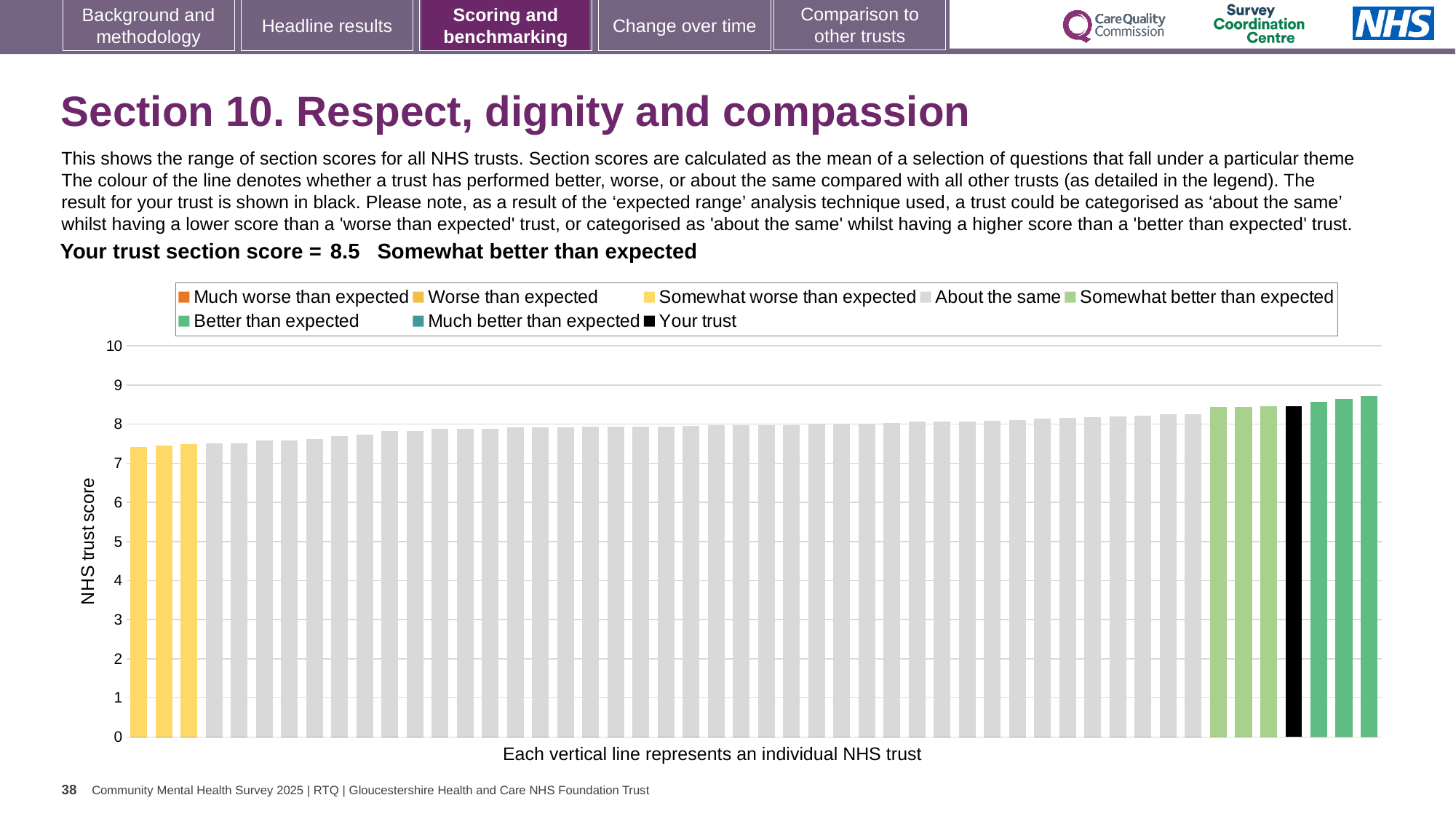
How many entries does the chart legend list? 8 Do the bar values rise or fall from left to right along the x axis? rise Is the value of the leftmost (lowest) bar greater or less than 8? less What is the label on the vertical axis of the chart? NHS trust score How many bars are to the right of the black bar representing your trust? 3 What is the highest value shown on the vertical axis? 10 Is the value of the rightmost (highest) bar greater or less than 9? less Is the value of the black bar (your trust) greater or less than 8? greater What kind of chart is shown on the slide? bar chart How many yellow bars are there at the left of the chart? 3 Which legend category does your trust fall into according to the slide? Somewhat better than expected What is the section score for your trust shown on the slide? 8.5